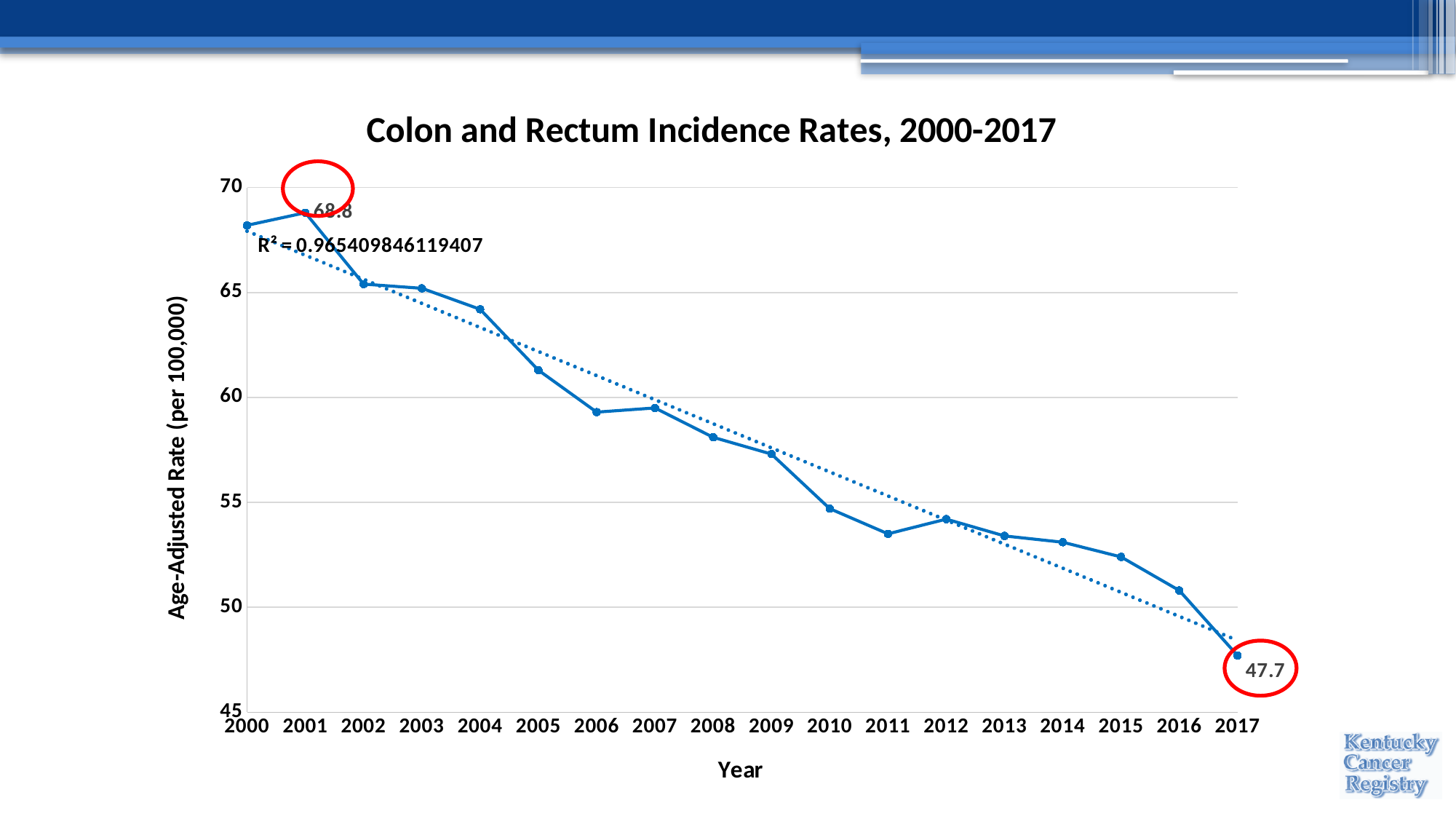
Is the incidence rate for 2010 greater or less than 55? less Is the incidence rate for 2005 greater or less than 65? less What is the age-adjusted colon and rectum incidence rate shown for 2001? 68.8 Which year has the lowest incidence rate on the chart? 2017 Which year has the higher incidence rate, 2006 or 2009? 2006 What kind of chart is shown on the slide? line chart How many years are plotted on the x axis? 18 Is the incidence rate for 2016 greater or less than 50? greater Do the incidence rates generally rise or fall from 2000 to 2017? fall What is the age-adjusted colon and rectum incidence rate shown for 2017? 47.7 By how much did the incidence rate fall from 2001 (68.8) to 2017 (47.7)? 21.1 What is the R² value printed on the chart for the trendline? R² = 0.965409846119407